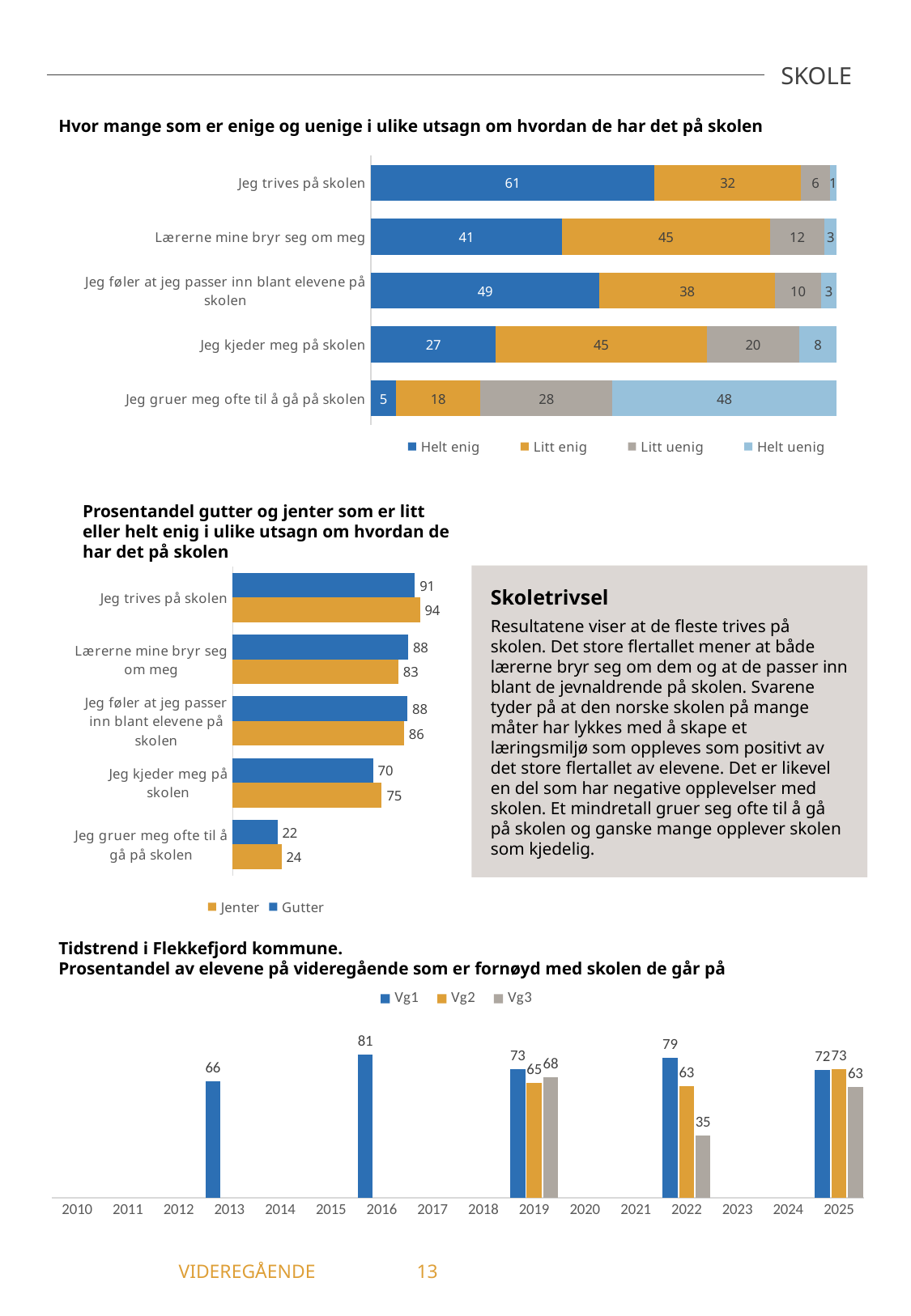
In the middle chart 'Prosentandel gutter og jenter som er litt eller helt enig i ulike utsagn om hvordan de har det på skolen', which statement has the lowest value for Gutter? Jeg gruer meg ofte til å gå på skolen In the top chart 'Hvor mange som er enige og uenige i ulike utsagn om hvordan de har det på skolen', what is the difference between the 'Litt enig' and 'Helt enig' values for 'Jeg kjeder meg på skolen'? 18 What kind of chart is the bottom chart 'Tidstrend i Flekkefjord kommune'? Bar chart In the top chart 'Hvor mange som er enige og uenige i ulike utsagn om hvordan de har det på skolen', which statement has the highest 'Helt enig' value? Jeg trives på skolen In the bottom chart 'Tidstrend i Flekkefjord kommune', which year has the highest Vg1 value? 2016 In the middle chart 'Prosentandel gutter og jenter som er litt eller helt enig i ulike utsagn om hvordan de har det på skolen', which is larger for 'Lærerne mine bryr seg om meg': Gutter or Jenter? Gutter In the top chart 'Hvor mange som er enige og uenige i ulike utsagn om hvordan de har det på skolen', what is the 'Helt uenig' value for 'Jeg gruer meg ofte til å gå på skolen'? 48 In the middle chart 'Prosentandel gutter og jenter som er litt eller helt enig i ulike utsagn om hvordan de har det på skolen', how many statements are shown? 5 In the bottom chart 'Tidstrend i Flekkefjord kommune', what is the Vg3 value for 2022? 35 In the top chart 'Hvor mange som er enige og uenige i ulike utsagn om hvordan de har det på skolen', what is the 'Helt enig' value for 'Jeg trives på skolen'? 61 In the top chart 'Hvor mange som er enige og uenige i ulike utsagn om hvordan de har det på skolen', how many series does the legend list? 4 In the middle chart 'Prosentandel gutter og jenter som er litt eller helt enig i ulike utsagn om hvordan de har det på skolen', what is the value for Jenter for 'Jeg trives på skolen'? 94